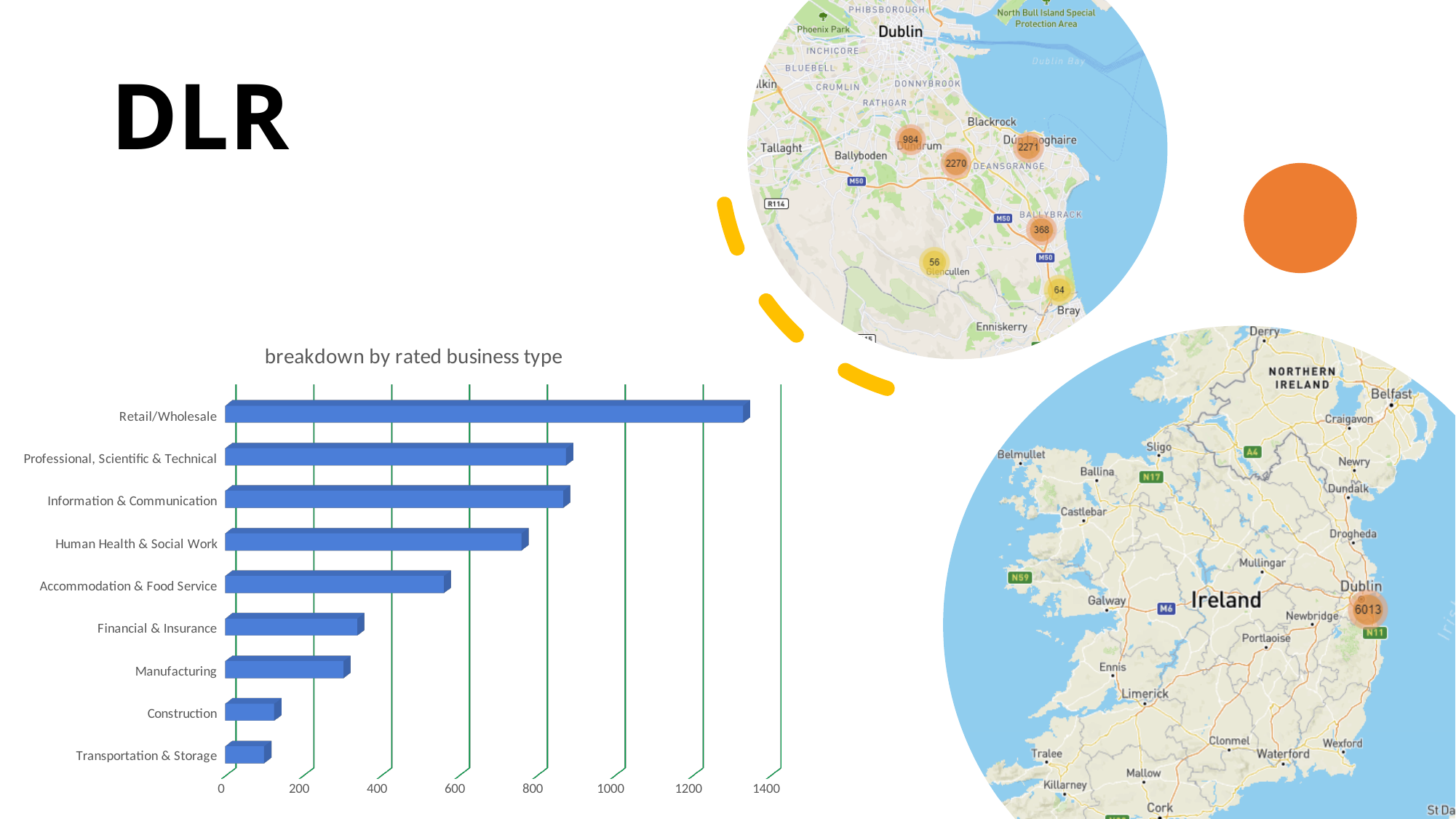
Is the value for Retail/Wholesale greater or less than 1200? greater Is the value for Human Health & Social Work greater or less than 600? greater Which business type has the lowest value in the chart? Transportation & Storage Which business type has the highest value in the chart? Retail/Wholesale What is the highest value shown on the chart's horizontal axis? 1400 Is the value for Financial & Insurance greater or less than 400? less What is the title of the chart? breakdown by rated business type What kind of chart is shown on the slide? bar chart How many business type categories are shown in the chart? 9 Which is larger, the value for Retail/Wholesale or the value for Human Health & Social Work? Retail/Wholesale